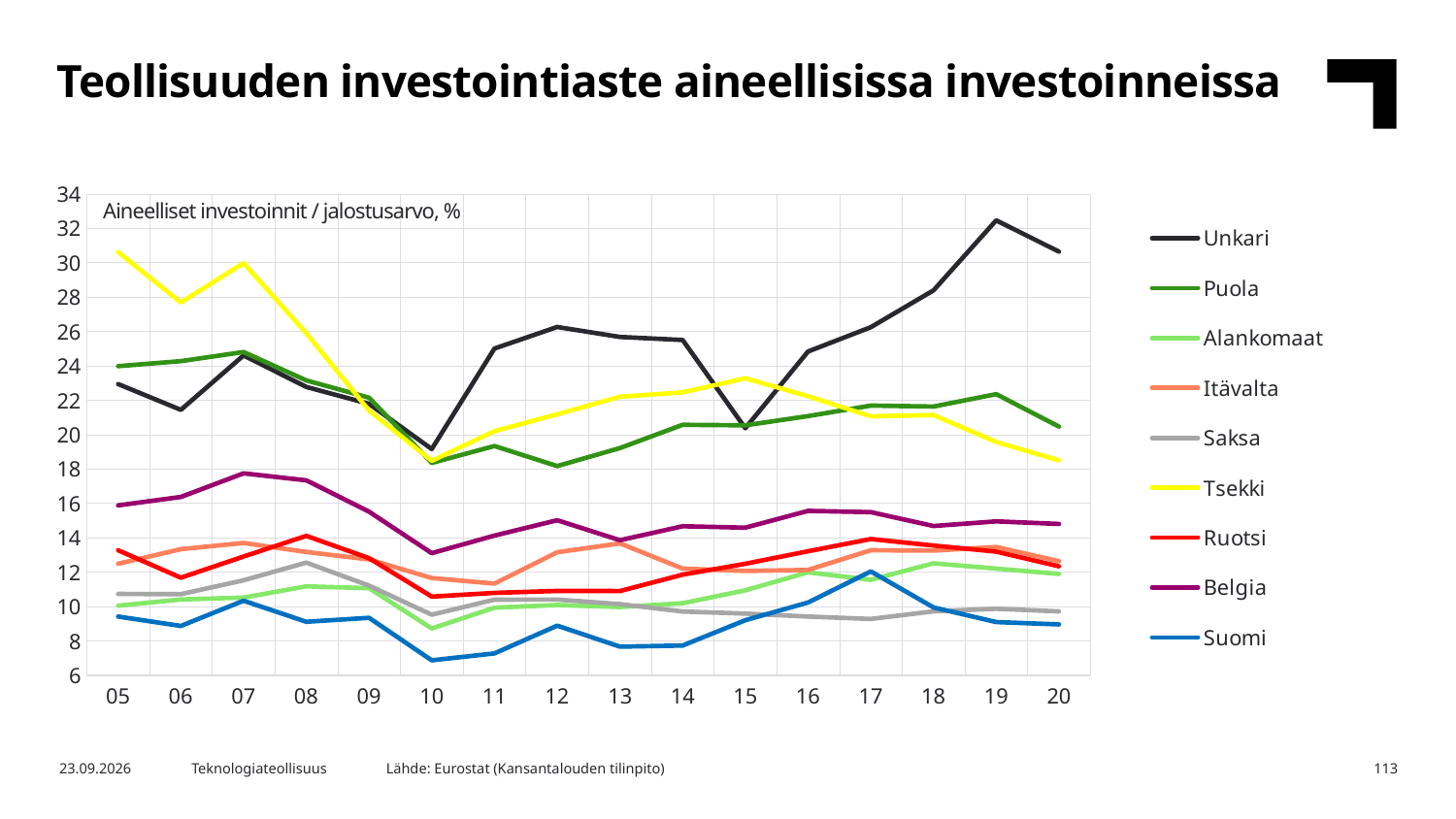
Is the value for Suomi in 2010 greater or less than 8? less Which country has the highest value in 2019? Unkari Does the value for Tsekki rise or fall from 2015 to 2020? Fall Which country has the lowest value in 2010? Suomi What label is printed inside the top-left corner of the plot area? Aineelliset investoinnit / jalostusarvo, % Which country has the highest value in 2005? Tsekki Which is larger in 2017, the value for Suomi or the value for Saksa? Suomi How many series does the legend list? 9 Is the value for Unkari in 2019 greater or less than 30? greater Is the value for Belgia in 2007 greater or less than 16? greater What kind of chart is shown on the slide? Line chart How many years are shown on the x axis? 16